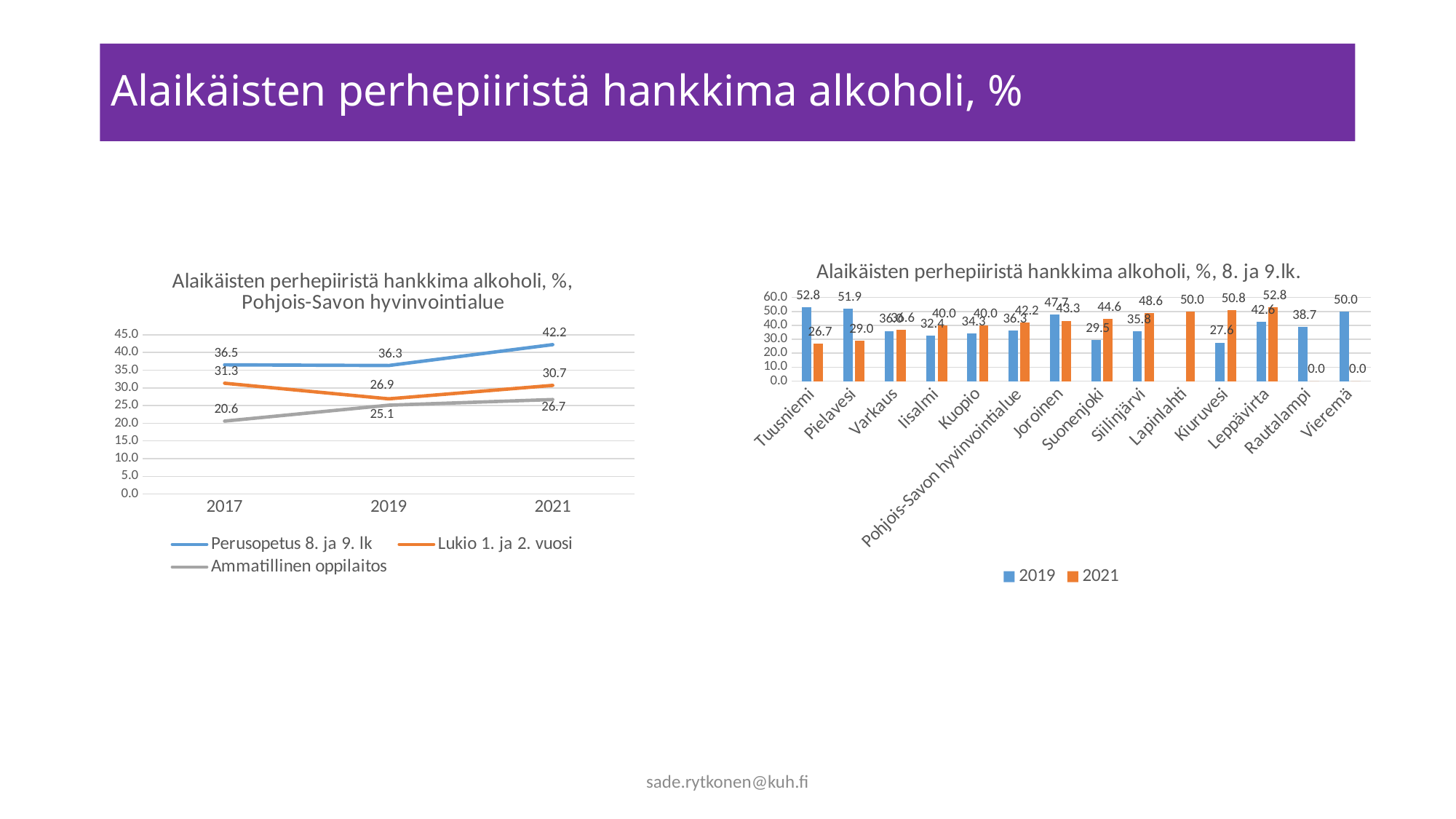
In the left chart, what is the difference between Perusopetus 8. ja 9. lk and Lukio 1. ja 2. vuosi in 2019? 9.4 In the left chart, does the Ammatillinen oppilaitos line rise or fall from 2017 to 2021? rise In the right chart, how many categories are shown on the x axis? 14 What type of chart is the left chart, 'Alaikäisten perhepiiristä hankkima alkoholi, %, Pohjois-Savon hyvinvointialue'? line chart What type of chart is the right chart, 'Alaikäisten perhepiiristä hankkima alkoholi, %, 8. ja 9.lk.'? bar chart In the left chart, what is the value for Perusopetus 8. ja 9. lk in 2021? 42.2 In the left chart, what is the value for Ammatillinen oppilaitos in 2017? 20.6 In the right chart, what is the difference between the 2019 and 2021 values for Tuusniemi? 26.1 In the right chart, which is larger for Suonenjoki, the 2019 value or the 2021 value? 2021 In the left chart, how many series does the legend list? 3 In the right chart, what is the 2021 value for Kiuruvesi? 50.8 In the right chart, which category has the highest 2019 value? Tuusniemi